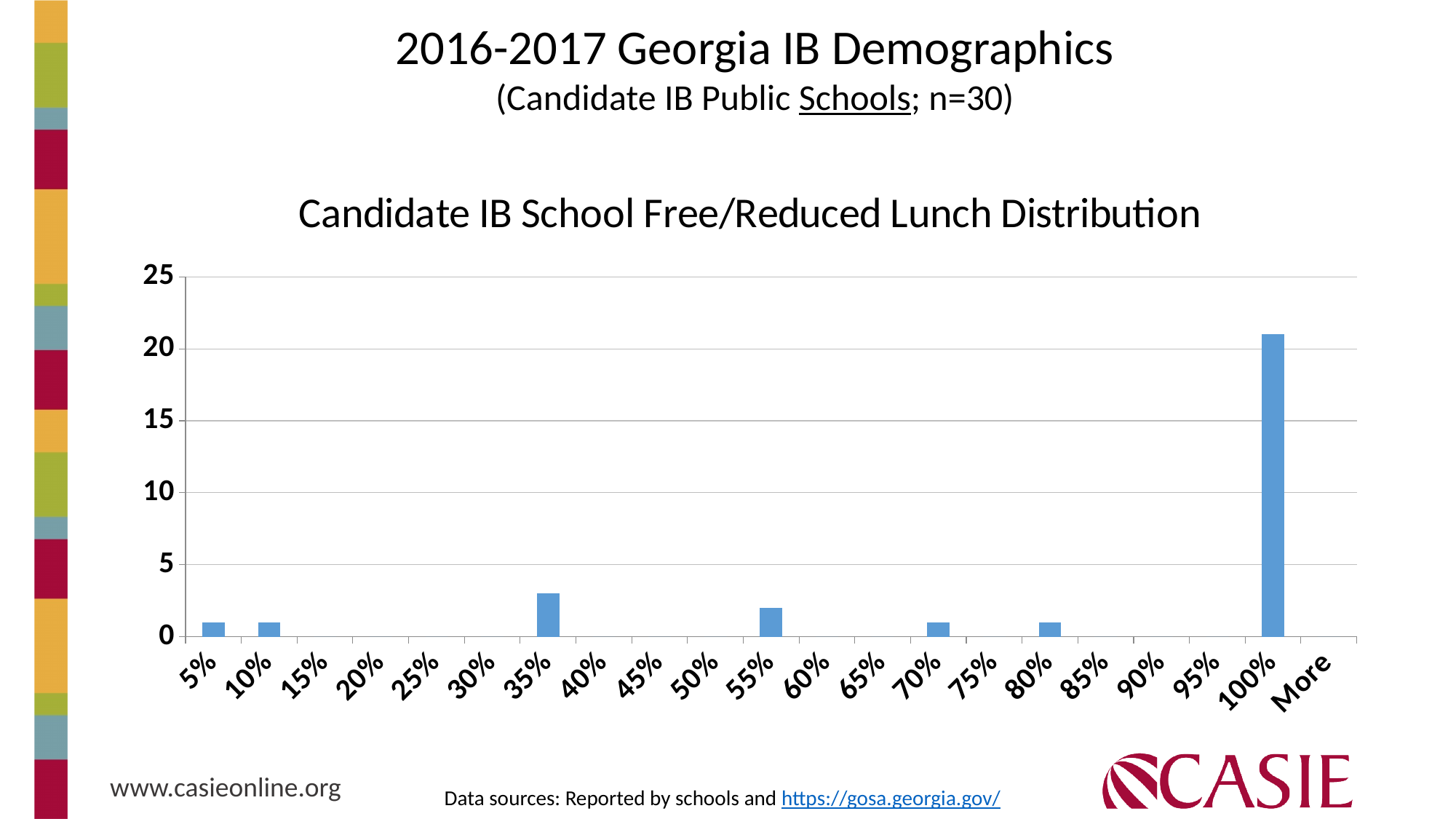
What is the title of the chart? Candidate IB School Free/Reduced Lunch Distribution What is the label of the last category on the x axis? More What kind of chart is shown on the slide? bar chart How many categories are shown on the x axis? 21 Is the value for 100% greater or less than 20? greater What is the highest value shown on the y axis? 25 Is the value for 35% greater or less than 5? less Is the value for 100% greater or less than 15? greater Which category has the highest bar? 100% Which is larger, the value for 100% or the value for 35%? 100% Which is larger, the value for 35% or the value for 55%? 35%